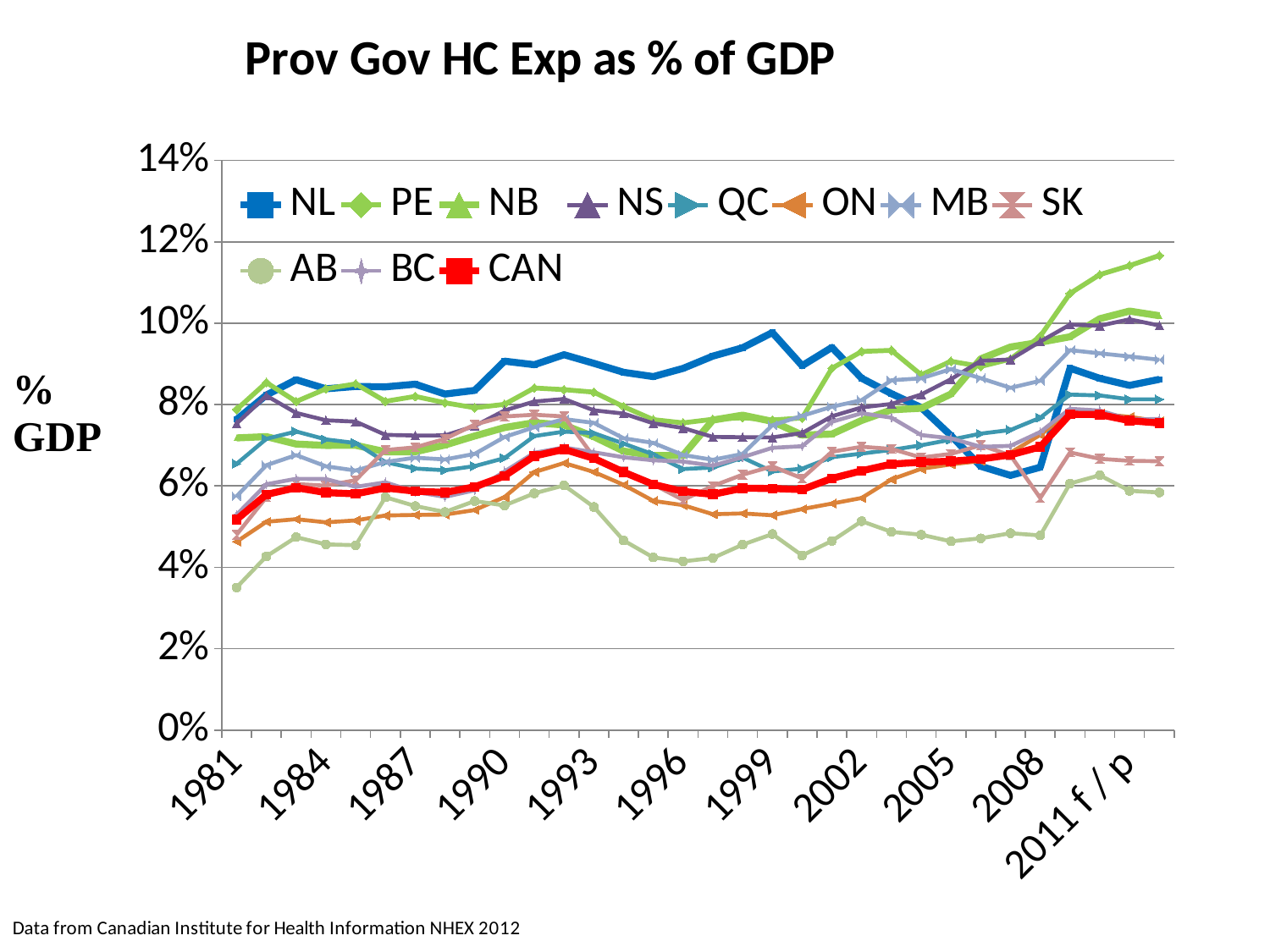
Does the NB series rise or fall between 2005 and 2011 f / p? rise How many series does the legend list? 11 What is the title of the chart? Prov Gov HC Exp as % of GDP Is the value for AB in 1981 greater or less than 4%? less Which series has the lowest value at 2011 f / p? AB What kind of chart is shown on the slide? line chart What label is shown on the vertical axis of the chart? % GDP Is the value for NB at 2011 f / p greater or less than 10%? greater Which series has the lowest value in 1981? AB Is the value for CAN in 1981 greater or less than 6%? less Which series has the highest value at 2011 f / p? PE